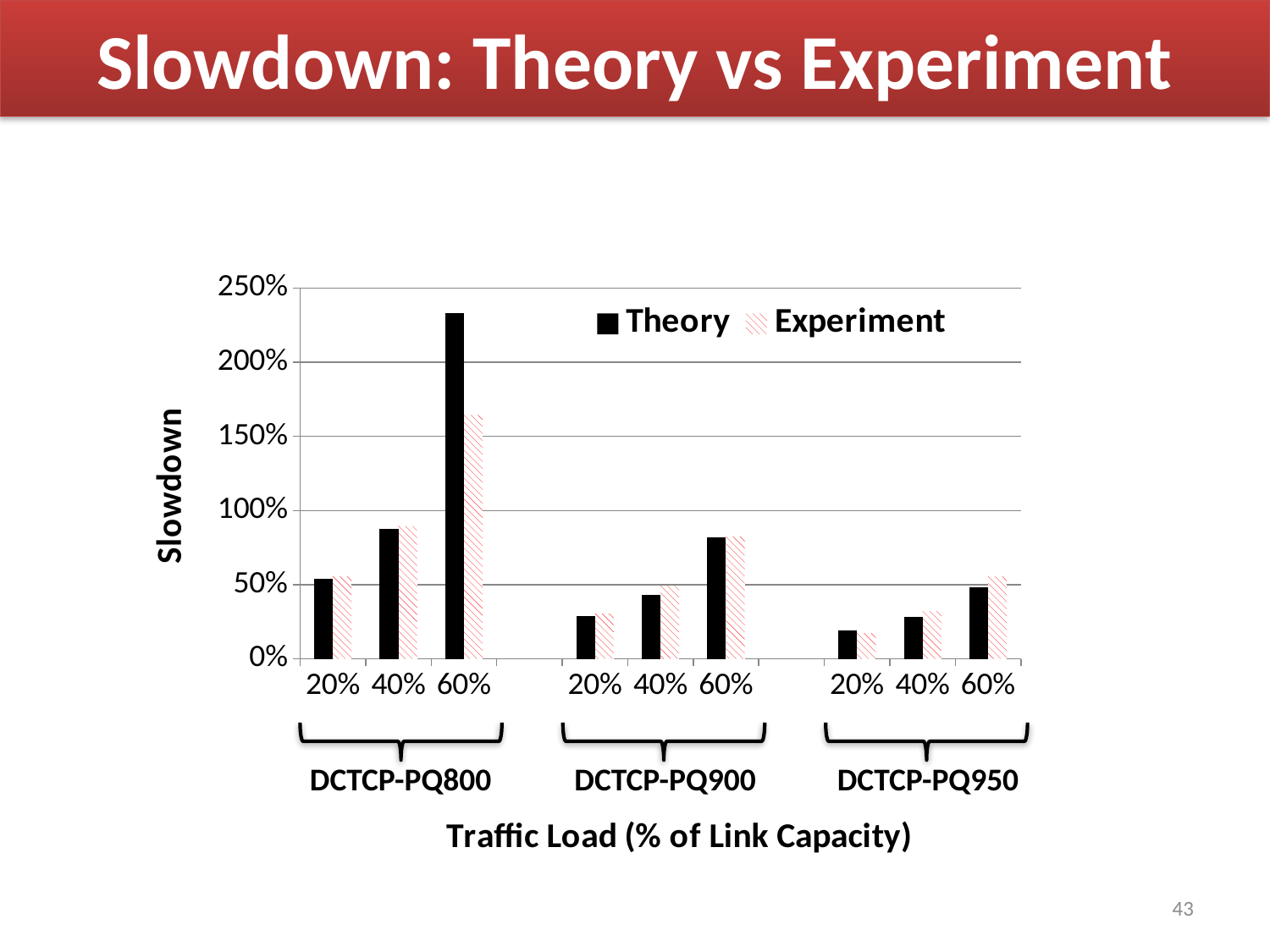
What are the two series named in the legend? Theory and Experiment Is the Experiment slowdown for DCTCP-PQ800 at 60% load greater or less than 200%? less What is the title of the vertical axis? Slowdown How many series does the legend list? 2 For DCTCP-PQ800 at 60% load, which is larger, the Theory or the Experiment slowdown? Theory Is the Theory slowdown for DCTCP-PQ800 at 60% load greater or less than 200%? greater Which group and traffic load has the lowest Theory slowdown? DCTCP-PQ950 at 20% What kind of chart is shown on the slide? bar chart Within the DCTCP-PQ800 group, do the Theory slowdown bars rise or fall as traffic load increases from 20% to 60%? rise How many traffic load levels are shown within each DCTCP-PQ group? 3 How many DCTCP-PQ groups are shown along the x axis? 3 Which group and traffic load has the highest Theory slowdown? DCTCP-PQ800 at 60%